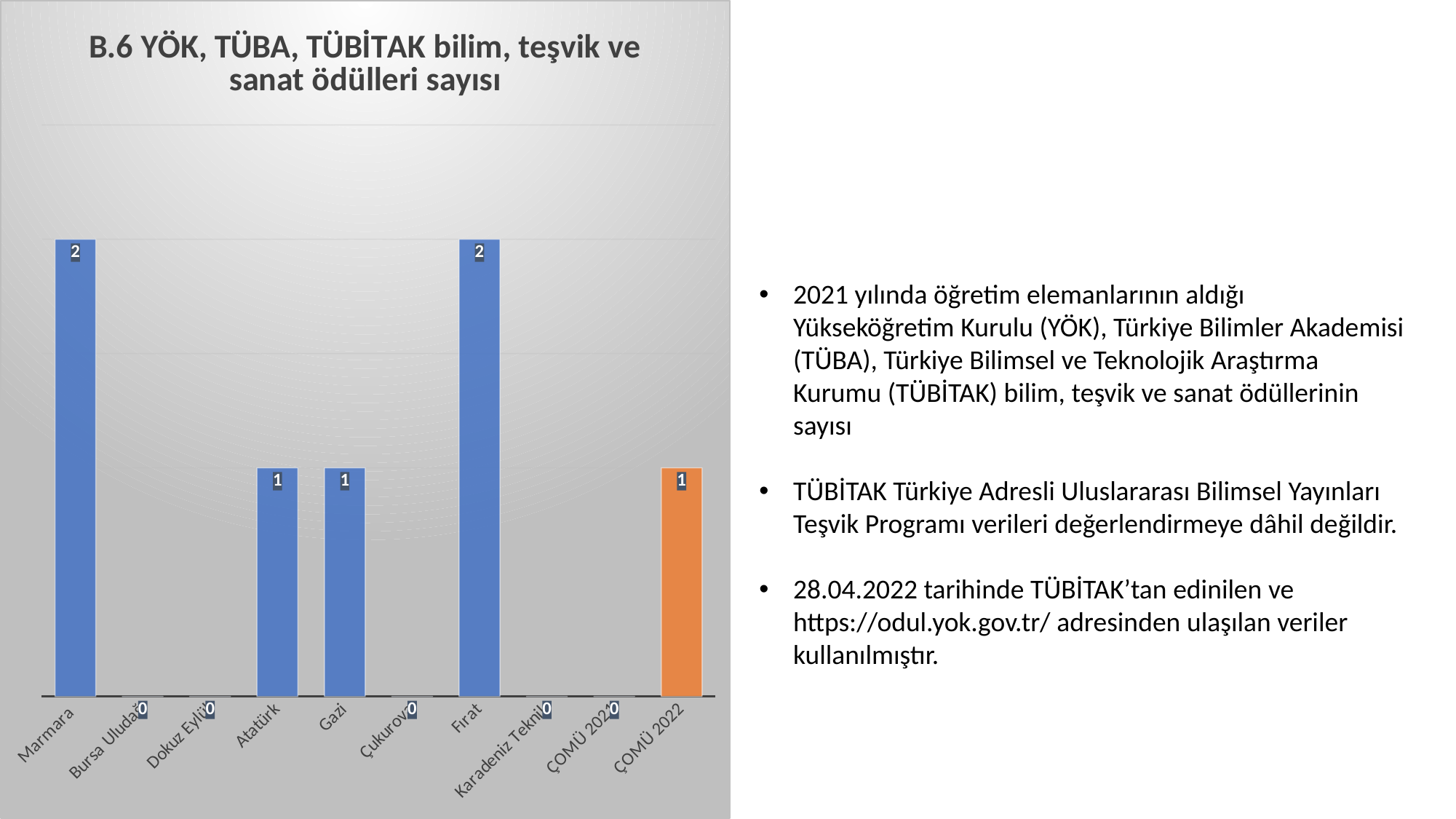
What is the value for Fırat? 2 What is the value for Marmara? 2 What kind of chart is shown? Bar chart What is the value for ÇOMÜ 2022? 1 What is the value for Karadeniz Teknik? 0 Which two categories share the highest value? Marmara and Fırat What is the difference between the values for Marmara and Gazi? 1 Which is larger, the value for Fırat or the value for ÇOMÜ 2022? Fırat How many categories are shown on the x axis? 10 Which category's bar is coloured orange instead of blue? ÇOMÜ 2022 What is the value for Atatürk? 1